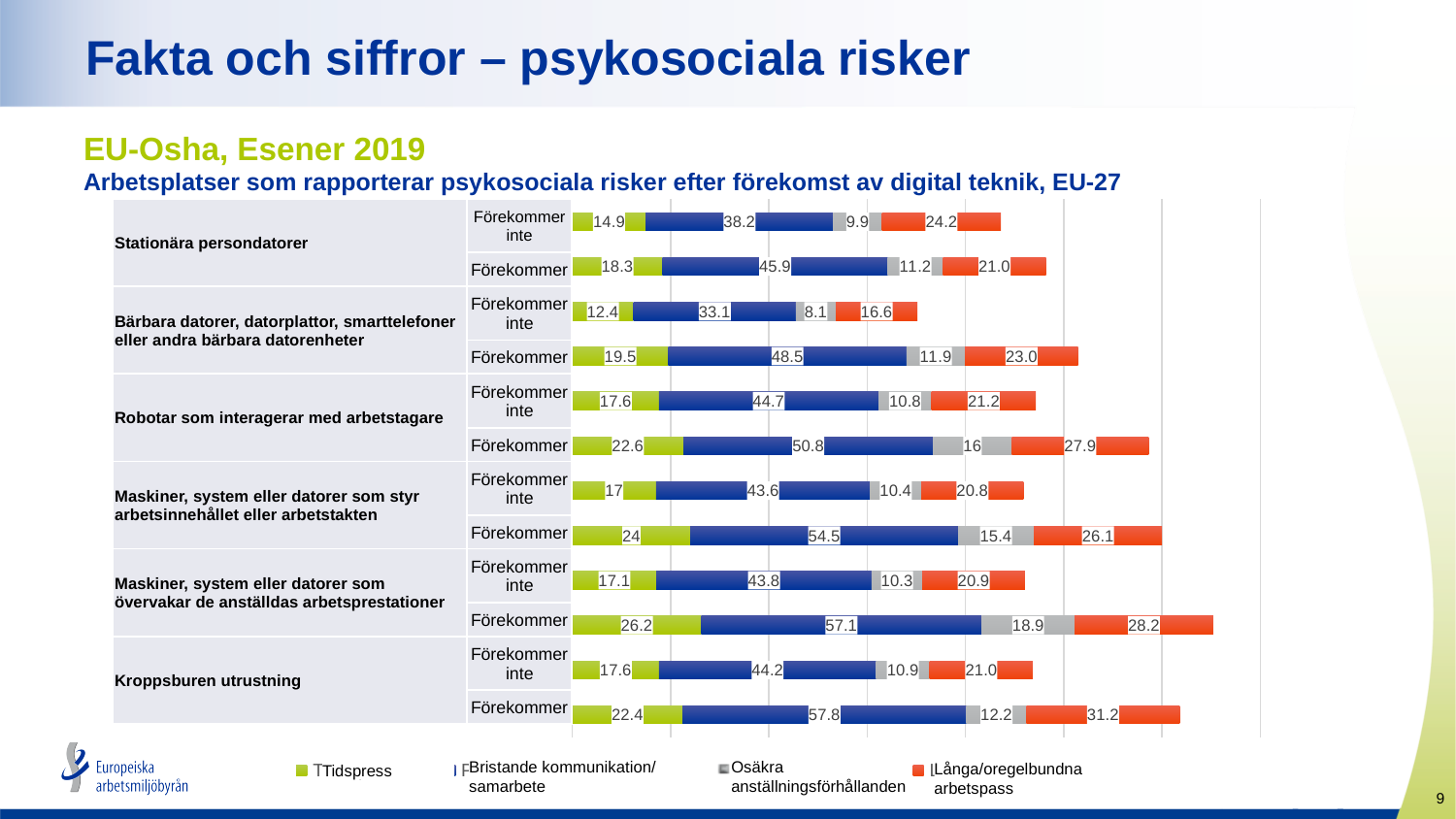
What is the 'Långa/oregelbundna arbetspass' value for 'Bärbara datorer, datorplattor, smarttelefoner eller andra bärbara datorenheter' where the technology 'Förekommer inte'? 16.6 Which bar has the highest Tidspress value? Maskiner, system eller datorer som övervakar de anställdas arbetsprestationer – Förekommer Which bar has the lowest Tidspress value? Bärbara datorer, datorplattor, smarttelefoner eller andra bärbara datorenheter – Förekommer inte Which series is shown in orange in the chart? Långa/oregelbundna arbetspass How many bars are plotted in the chart? 12 How many series does the legend list? 4 What kind of chart is shown on the slide? stacked bar chart What is the Tidspress value for 'Stationära persondatorer' where the technology 'Förekommer inte'? 14.9 For 'Robotar som interagerar med arbetstagare', which is larger: the 'Osäkra anställningsförhållanden' value for 'Förekommer' or for 'Förekommer inte'? Förekommer What is the difference in the 'Bristande kommunikation/samarbete' value for 'Stationära persondatorer' between 'Förekommer' and 'Förekommer inte'? 7.7 What is the total of the stacked bar for 'Kroppsburen utrustning' – 'Förekommer'? 123.6 What is the 'Bristande kommunikation/samarbete' value for 'Kroppsburen utrustning' where the technology 'Förekommer'? 57.8